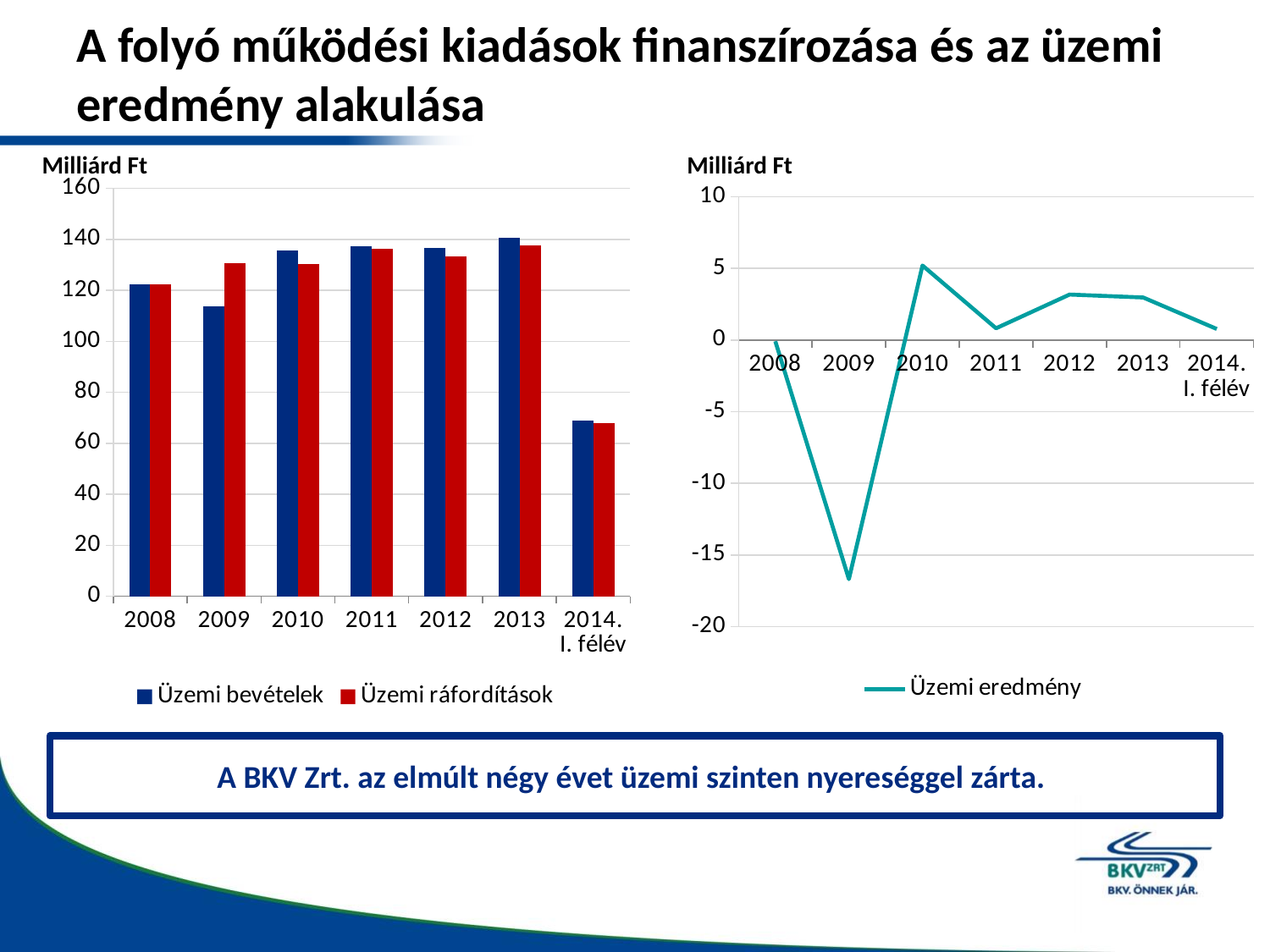
In the right chart, is the Üzemi eredmény for 2009 greater or less than -15? less In the left chart, how many series does the legend list? 2 What kind of chart is the right chart on the slide? line chart In the right chart, which year has the lowest Üzemi eredmény? 2009 What is the legend entry of the right chart? Üzemi eredmény In the right chart, which year has the highest Üzemi eredmény? 2010 In the left chart, for 2009, which is larger: Üzemi bevételek or Üzemi ráfordítások? Üzemi ráfordítások In the left chart, which category has the lowest Üzemi bevételek? 2014. I. félév What kind of chart is the left chart on the slide? bar chart In the left chart, is the value of Üzemi bevételek for 2014. I. félév greater or less than 80? less In the left chart, how many categories are shown on the x axis? 7 In the left chart, is the value of Üzemi bevételek for 2013 greater or less than 120? greater